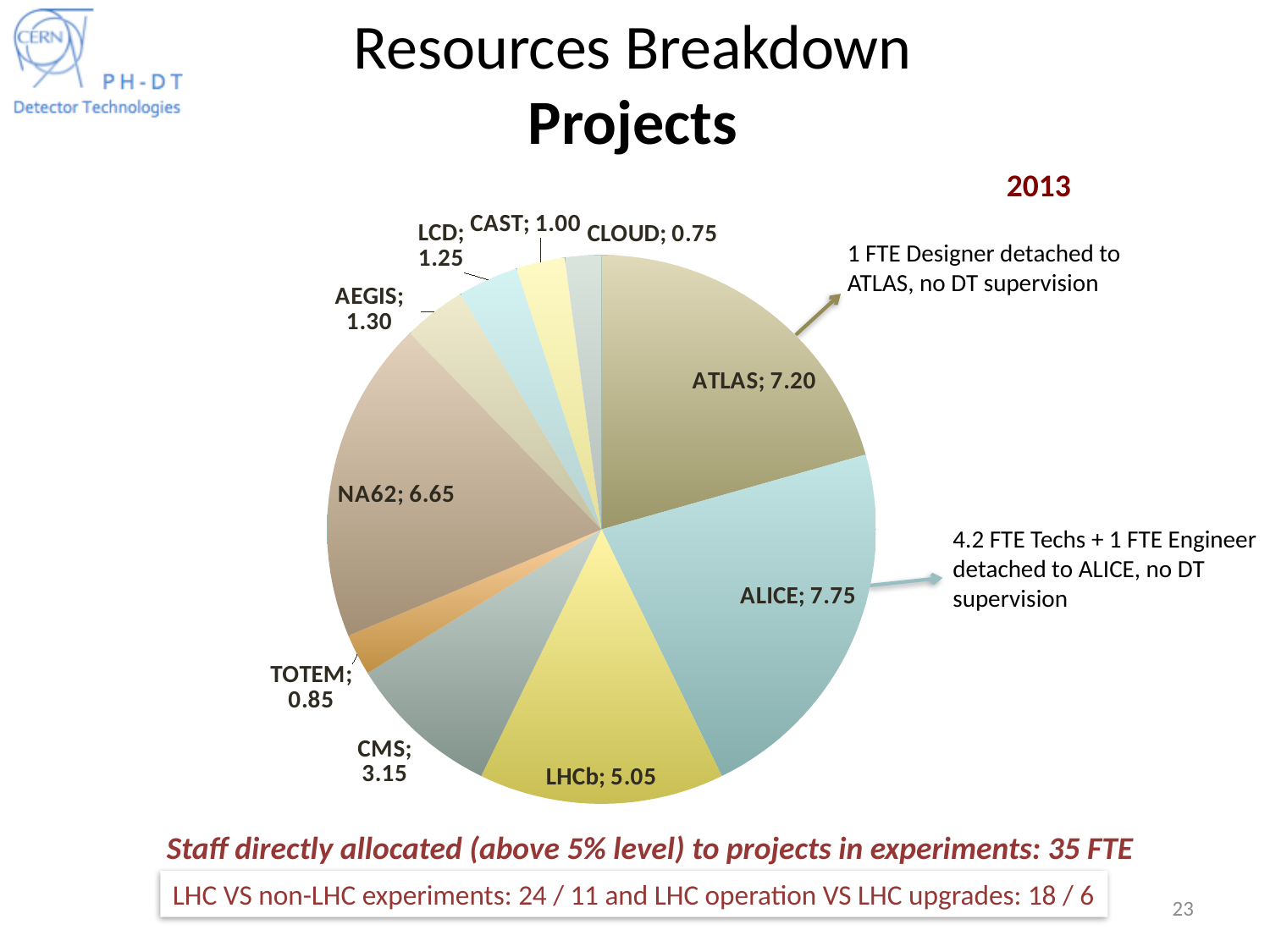
Which project has the smallest slice of the pie chart? CLOUD Which year does the pie chart refer to, according to the label next to it? 2013 Which is larger, the value for CMS or the value for NA62? NA62 What is the difference between the values for NA62 and LHCb? 1.60 What is the value for ATLAS in the pie chart? 7.20 What is the value for TOTEM in the pie chart? 0.85 What is the value for CAST in the pie chart? 1.00 What kind of chart is shown on the slide? pie chart Which project has the largest slice of the pie chart? ALICE What is the value for NA62 in the pie chart? 6.65 What is the difference between the values for ALICE and ATLAS? 0.55 How many projects (slices) are shown in the pie chart? 10